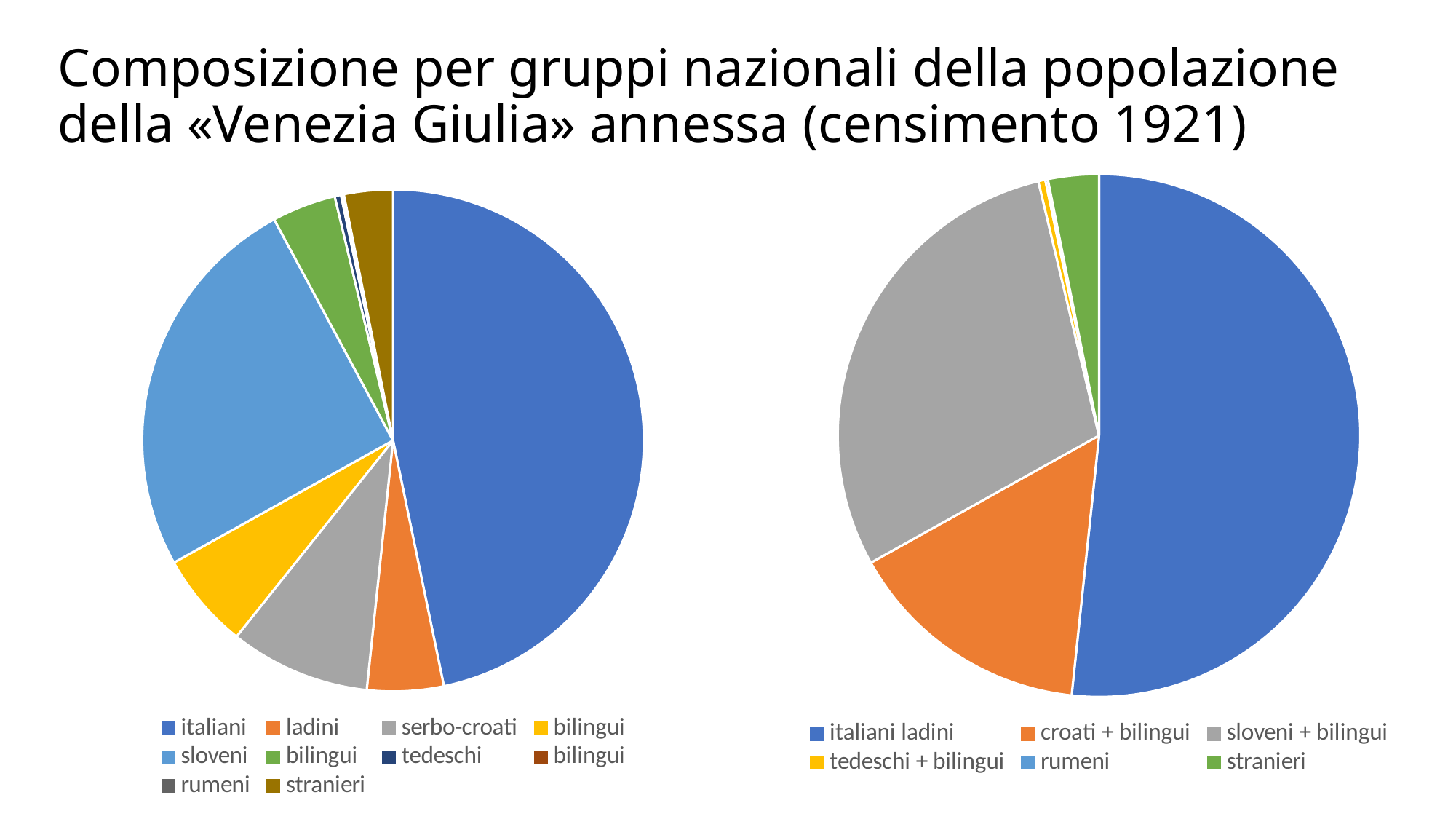
How many categories does the legend of the right pie chart list? 6 How many categories does the legend of the left pie chart list? 10 In the left pie chart, which slice is larger, sloveni or ladini? sloveni In the left pie chart, which slice is larger, serbo-croati or ladini? serbo-croati What kind of chart is the chart on the left of the slide? pie chart What kind of chart is the chart on the right of the slide? pie chart In the right pie chart, which slice is larger, croati + bilingui or stranieri? croati + bilingui In the right pie chart, what colour is the slice for sloveni + bilingui? grey In the right pie chart, which category has the largest slice? italiani ladini What is the title of the slide containing the two pie charts? Composizione per gruppi nazionali della popolazione della «Venezia Giulia» annessa (censimento 1921) In the left pie chart, which category has the largest slice? italiani